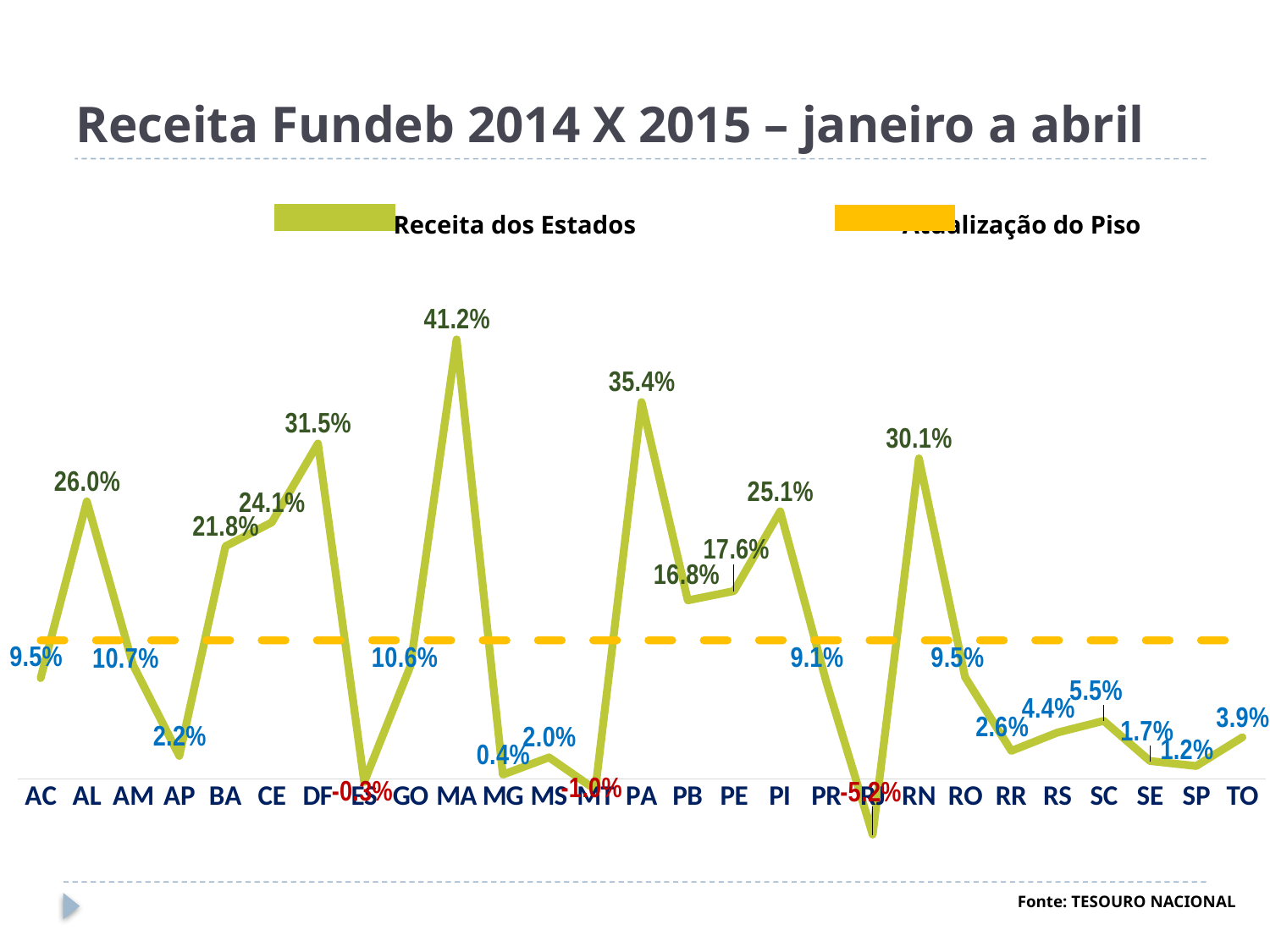
Which state has the highest value in the chart? MA What is the difference between the values for DF and CE? 7.4 percentage points Which has a larger value, PB or PE? PE What kind of chart is shown on the slide? Line chart What is the difference between the values for MA and PA? 5.8 percentage points Which has a larger value, AL or RN? RN What is the value for PI? 25.1% How many states are shown on the x axis? 27 What is the value for MA in the Receita dos Estados series? 41.2% What is the value for DF? 31.5% What is the value for SP? 1.2% How many series does the legend list? 2